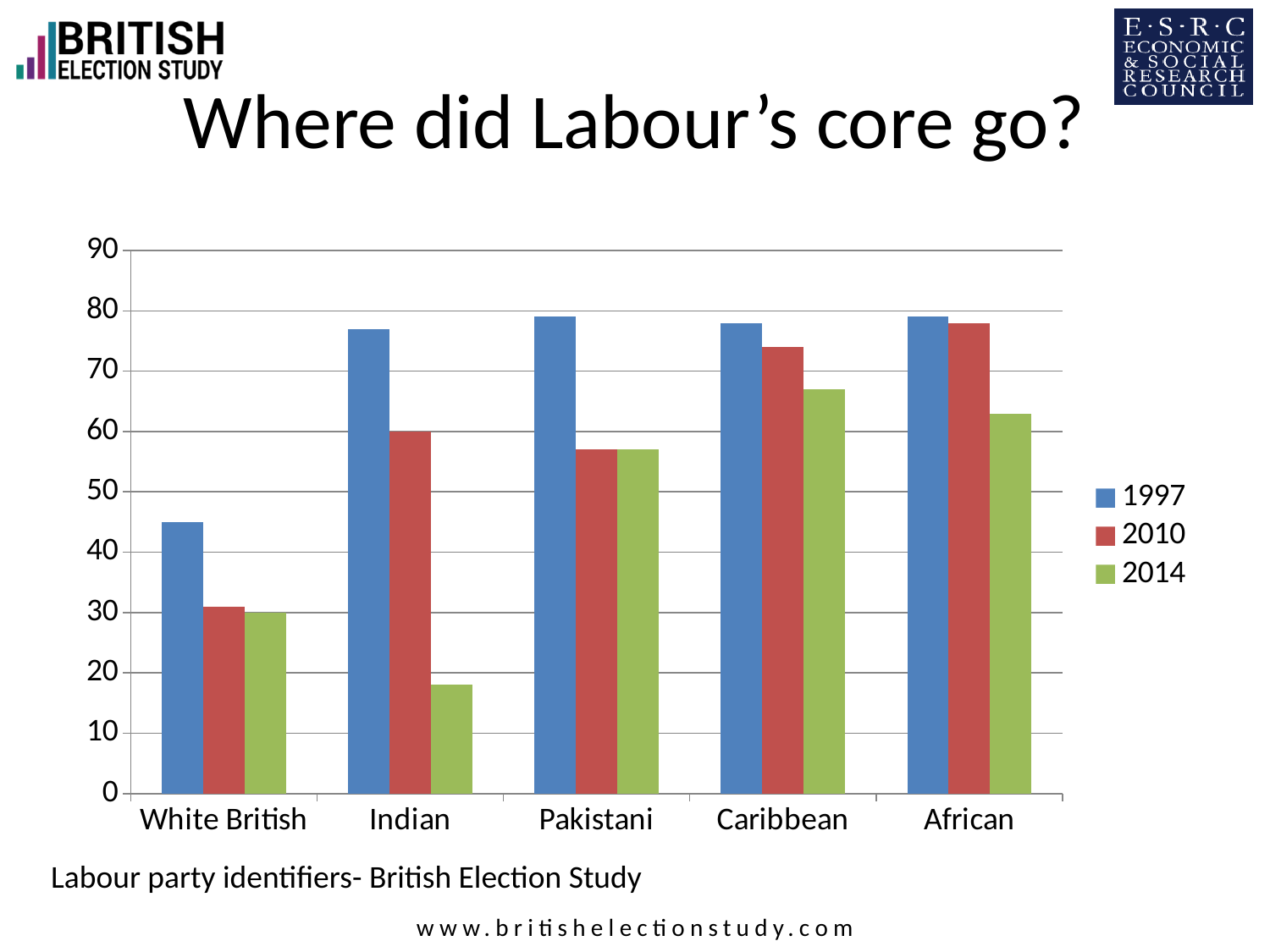
Which is larger for the 2014 series: White British or Indian? White British Is the value for White British in 1997 greater or less than 50? less Which series are listed in the legend? 1997, 2010, 2014 Is the value for Indian in 2014 greater or less than 20? less Which category has the lowest value for the 1997 series? White British What kind of chart is shown on the slide? bar chart How many categories are shown on the x axis? 5 Is the value for Pakistani in 1997 greater or less than 70? greater What is the title of the slide containing the chart? Where did Labour's core go? Which category has the highest value for the 2014 series? Caribbean How many series does the legend list? 3 Which category has the lowest value for the 2014 series? Indian